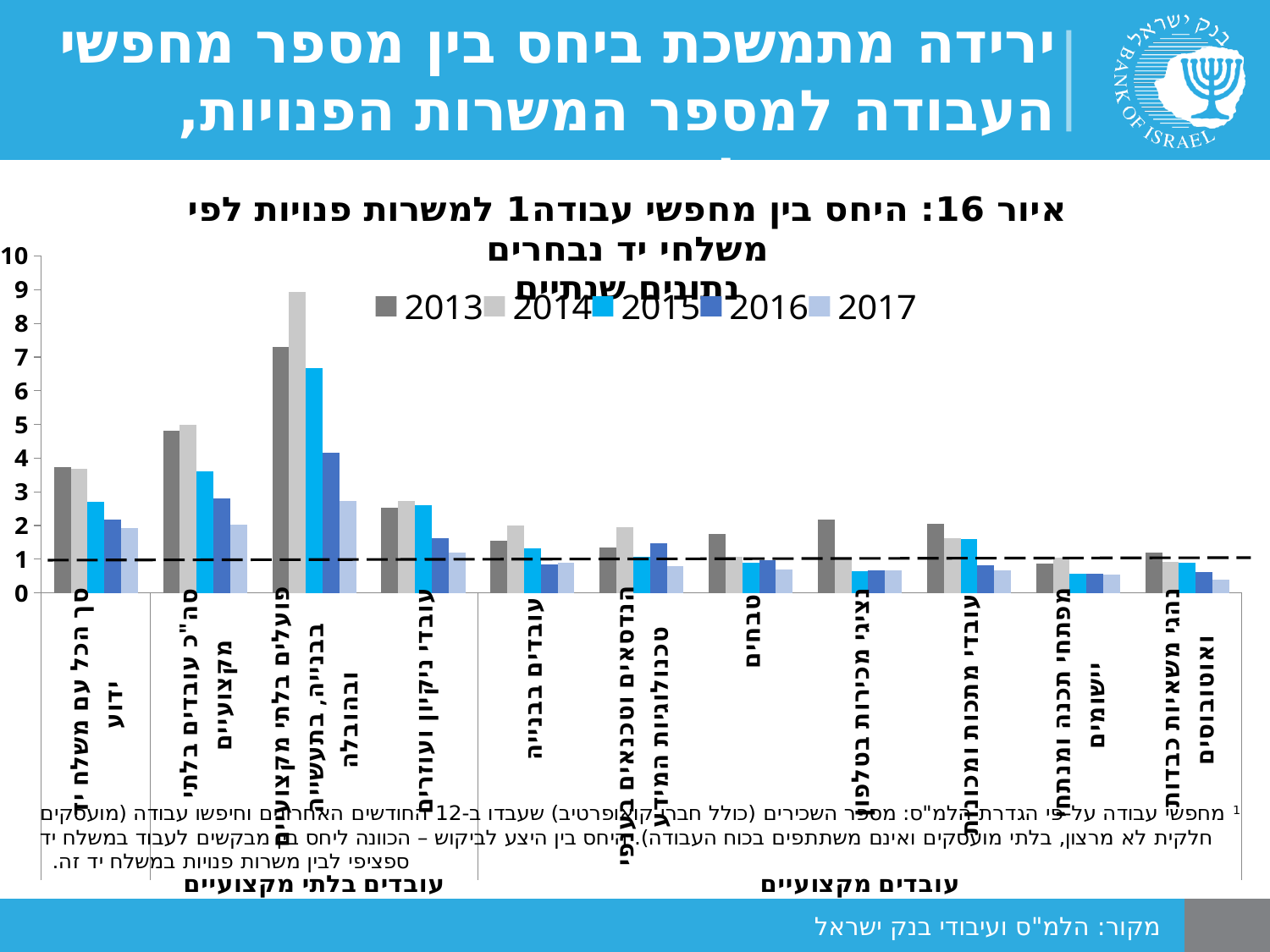
What kind of chart is shown on the slide? bar chart At what value on the y axis is the dashed horizontal line drawn? 1 Is the 2017 value for סך הכל עם משלח יד ידוע greater or less than 3? less Which years are listed in the legend? 2013, 2014, 2015, 2016, 2017 Is the 2015 value for פועלים בלתי מקצועיים בבנייה, בתעשייה ובהובלה greater or less than 6? greater How many series does the legend list? 5 For עובדי ניקיון ועוזרים, which is larger: the 2013 value or the 2016 value? 2013 For סך הכל עם משלח יד ידוע, do the values rise or fall from 2013 to 2017? fall For סה"כ עובדים בלתי מקצועיים, which is larger: the 2014 value or the 2017 value? 2014 Which category has the highest 2014 value? פועלים בלתי מקצועיים בבנייה, בתעשייה ובהובלה Is the 2013 value for סך הכל עם משלח יד ידוע greater or less than 3? greater